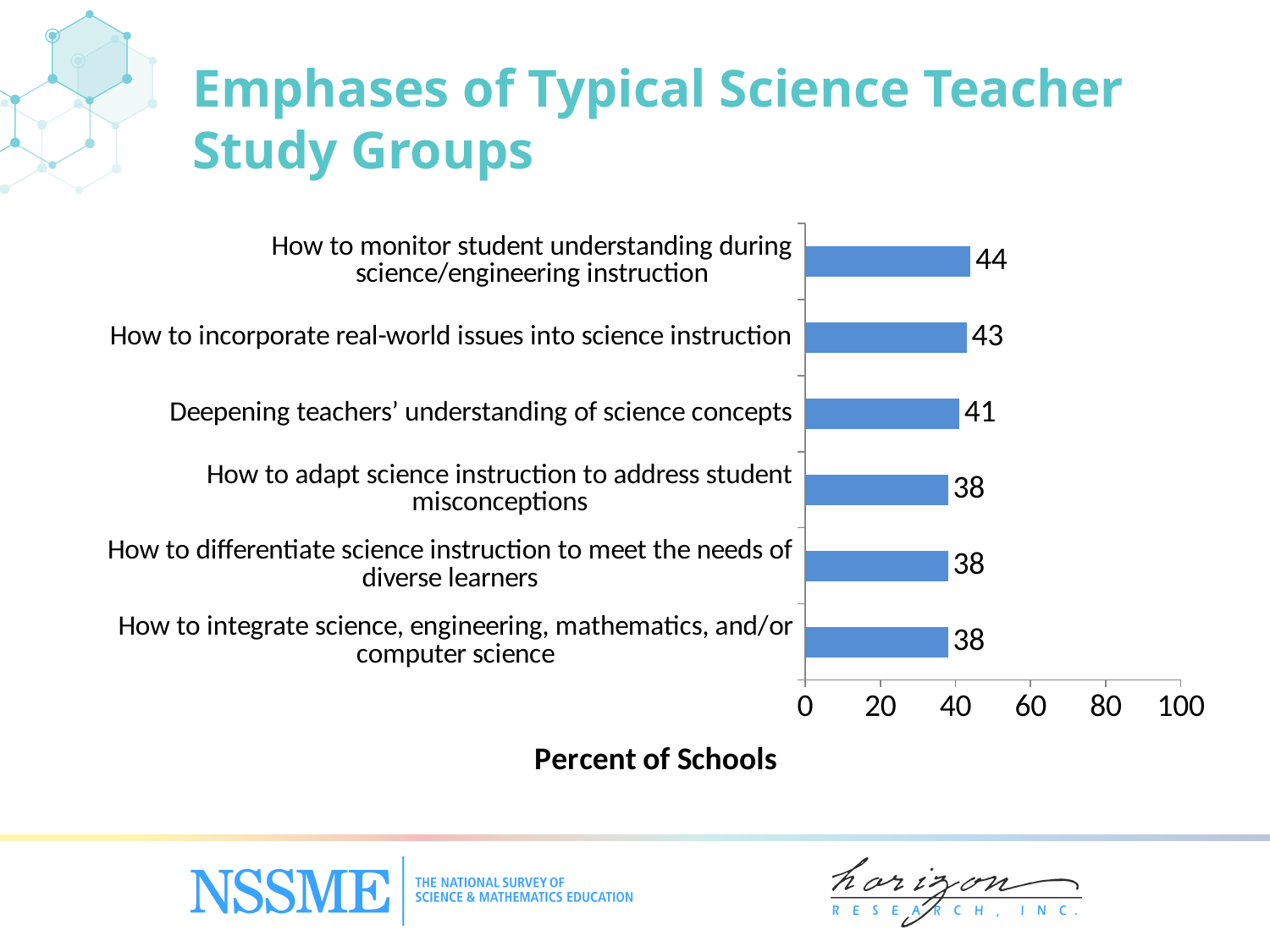
What is the difference between the values for monitoring student understanding and deepening teachers' understanding of science concepts? 3 How many categories are shown in the chart? 6 What percent of schools reported study groups emphasizing how to monitor student understanding during science/engineering instruction? 44 What is the value for 'Deepening teachers' understanding of science concepts'? 41 What kind of chart is shown on the slide? bar chart What is the value for 'How to integrate science, engineering, mathematics, and/or computer science'? 38 What is the value for 'How to incorporate real-world issues into science instruction'? 43 Which category has the highest value? How to monitor student understanding during science/engineering instruction What is the label of the horizontal axis? Percent of Schools Is the value for 'How to differentiate science instruction to meet the needs of diverse learners' greater or less than 60? less How many categories have a value of 38? 3 Which is larger: the value for incorporating real-world issues or the value for adapting instruction to address student misconceptions? How to incorporate real-world issues into science instruction